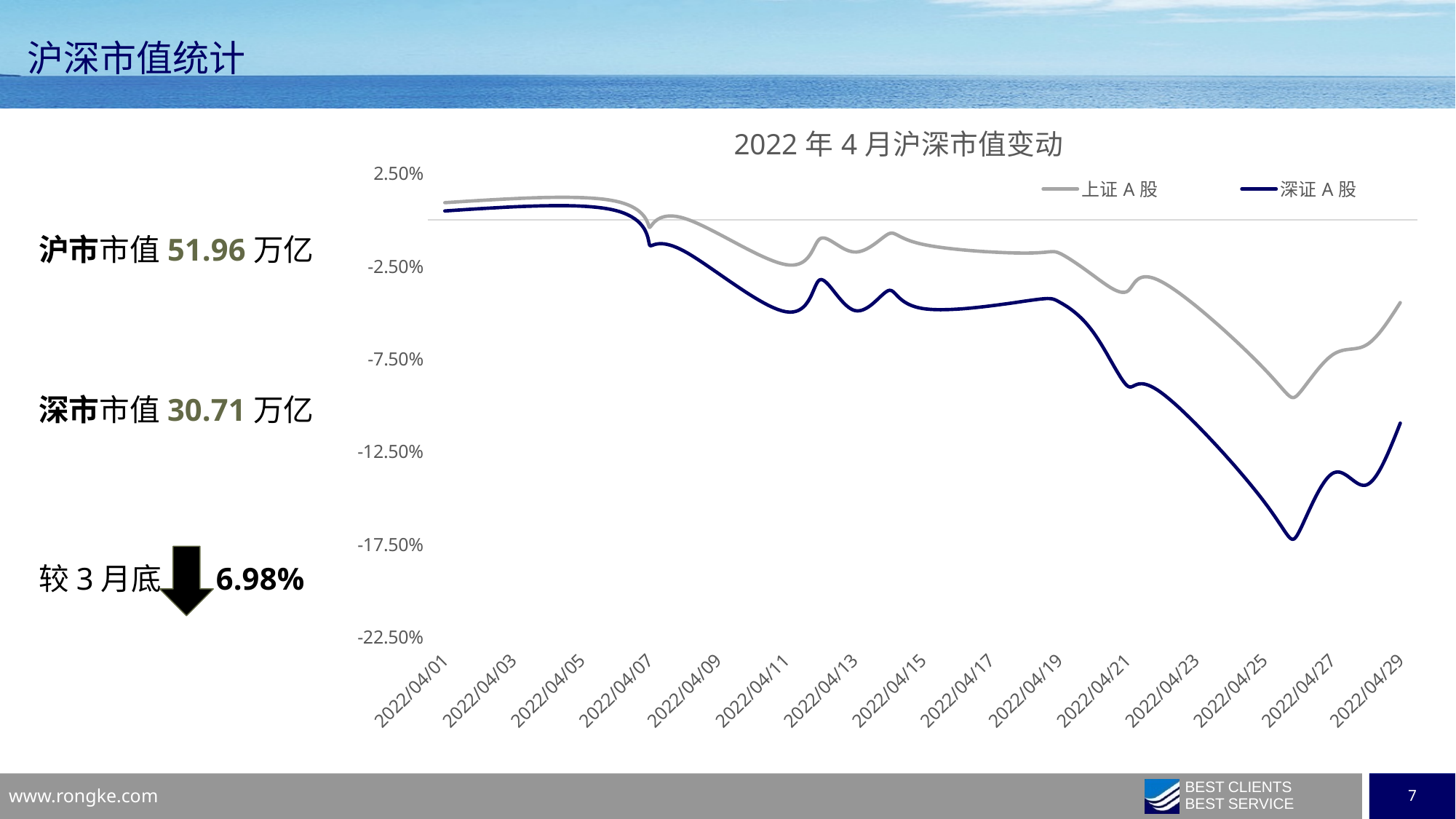
Overall, do the values for 深证A股 rise or fall from 2022/04/01 to 2022/04/29? fall Which series is drawn in dark blue in the chart? 深证A股 Is the value for 深证A股 at 2022/04/29 greater or less than -7.50%? less Is the value for 上证A股 at 2022/04/29 greater or less than -7.50%? greater Is the value for 深证A股 at 2022/04/19 greater or less than -2.50%? less What kind of chart is shown on the slide? line chart Which series has the lower value at 2022/04/29, 上证A股 or 深证A股? 深证A股 How many date labels are shown on the x axis of the chart? 15 Which series reaches the lowest point on the chart? 深证A股 How many series does the chart legend list? 2 What is the title of the chart? 2022年4月沪深市值变动